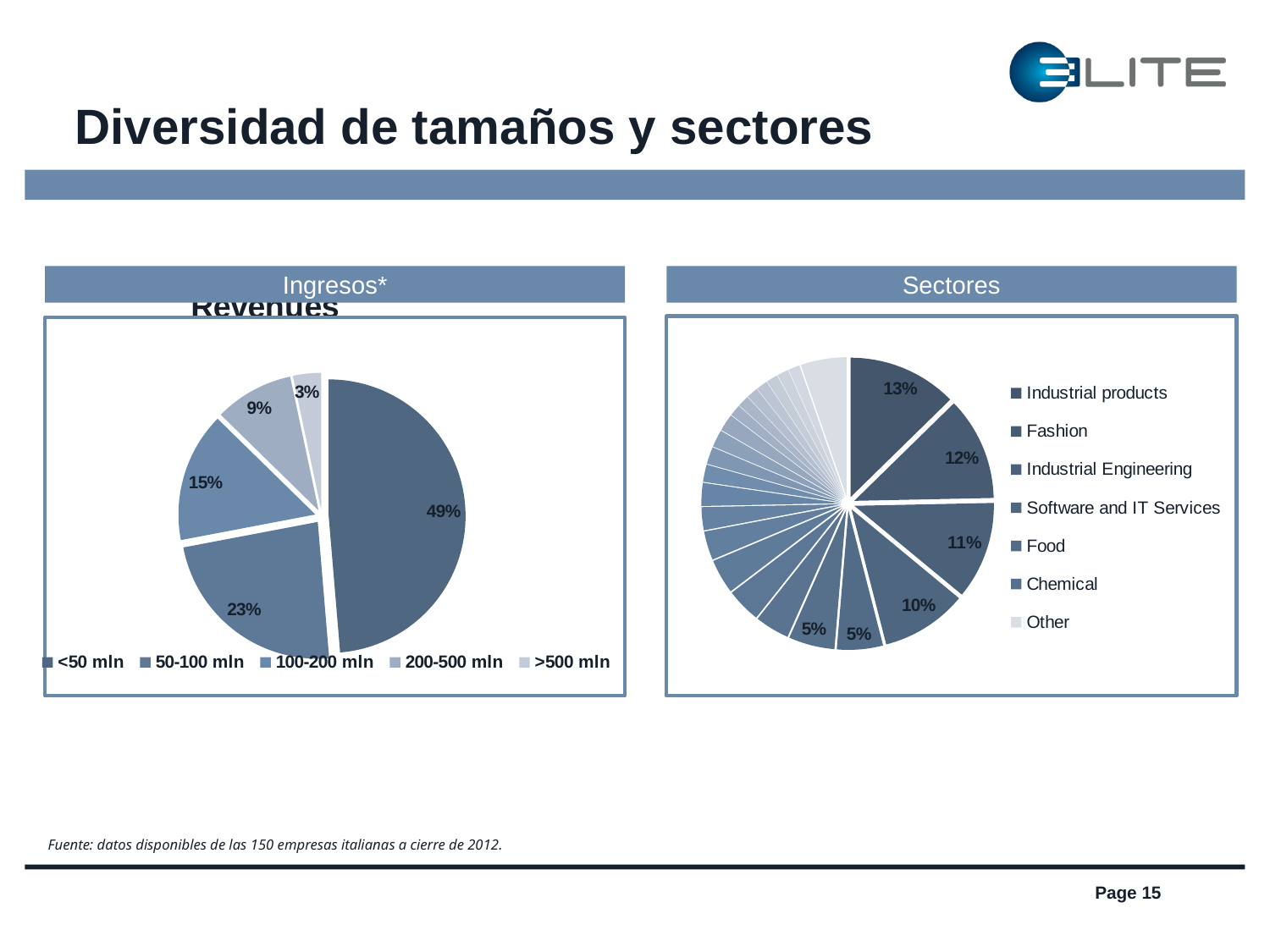
On the Sectores chart, what share is labelled for Industrial products? 13% On the Ingresos (Revenues) chart, what is the difference between the 100-200 mln share and the 200-500 mln share? 6% On the Ingresos (Revenues) chart, how many revenue categories does the legend list? 5 What type of chart is used on the Sectores chart? Pie chart On the Sectores chart, what share is labelled for Software and IT Services? 10% On the Ingresos (Revenues) chart, what share corresponds to the >500 mln category? 3% How many entries does the legend of the Sectores chart list? 7 On the Ingresos (Revenues) chart, what share corresponds to the 50-100 mln category? 23% On the Sectores chart, which is larger, the Fashion share or the Industrial Engineering share? Fashion On the Sectores chart, what is the difference between the Industrial products share and the Food share? 8% On the Ingresos (Revenues) chart, what share of companies have revenues below 50 mln? 49% On the Ingresos (Revenues) chart, which revenue category has the largest share? <50 mln